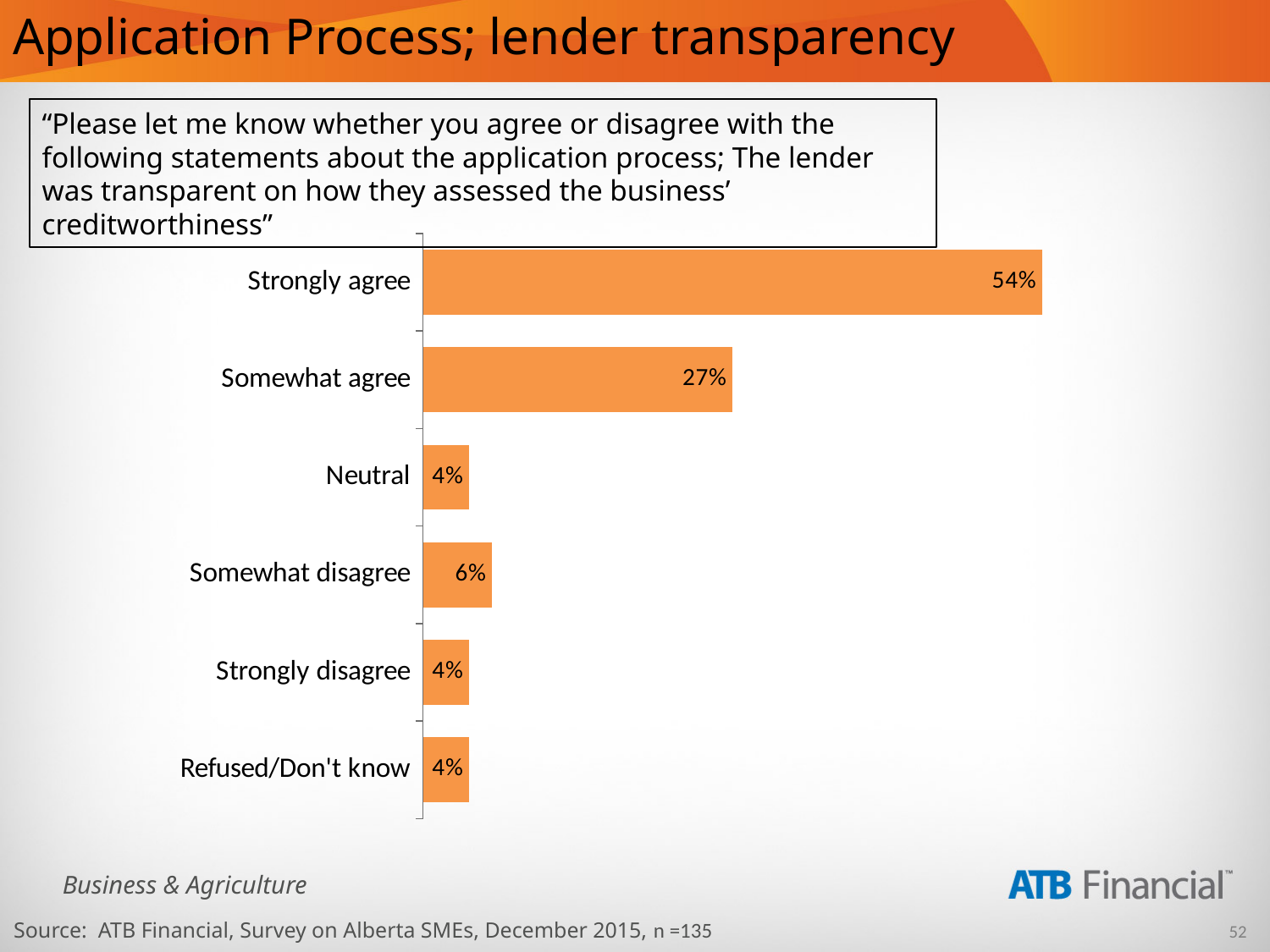
What percentage of respondents answered "Strongly agree"? 54% What kind of chart is shown on the slide? Bar chart Which response category has the highest percentage? Strongly agree What colour are the bars in the chart? Orange What is the difference in percentage points between "Somewhat disagree" and "Neutral"? 2 What is the combined percentage of "Strongly agree" and "Somewhat agree" responses? 81% What percentage of respondents answered "Somewhat disagree"? 6% What is the difference in percentage points between "Strongly agree" and "Somewhat agree"? 27 What percentage of respondents answered "Somewhat agree"? 27% How many response categories are shown in the chart? 6 What percentage of respondents answered "Refused/Don't know"? 4% Which is larger, the value for "Somewhat disagree" or the value for "Strongly disagree"? Somewhat disagree